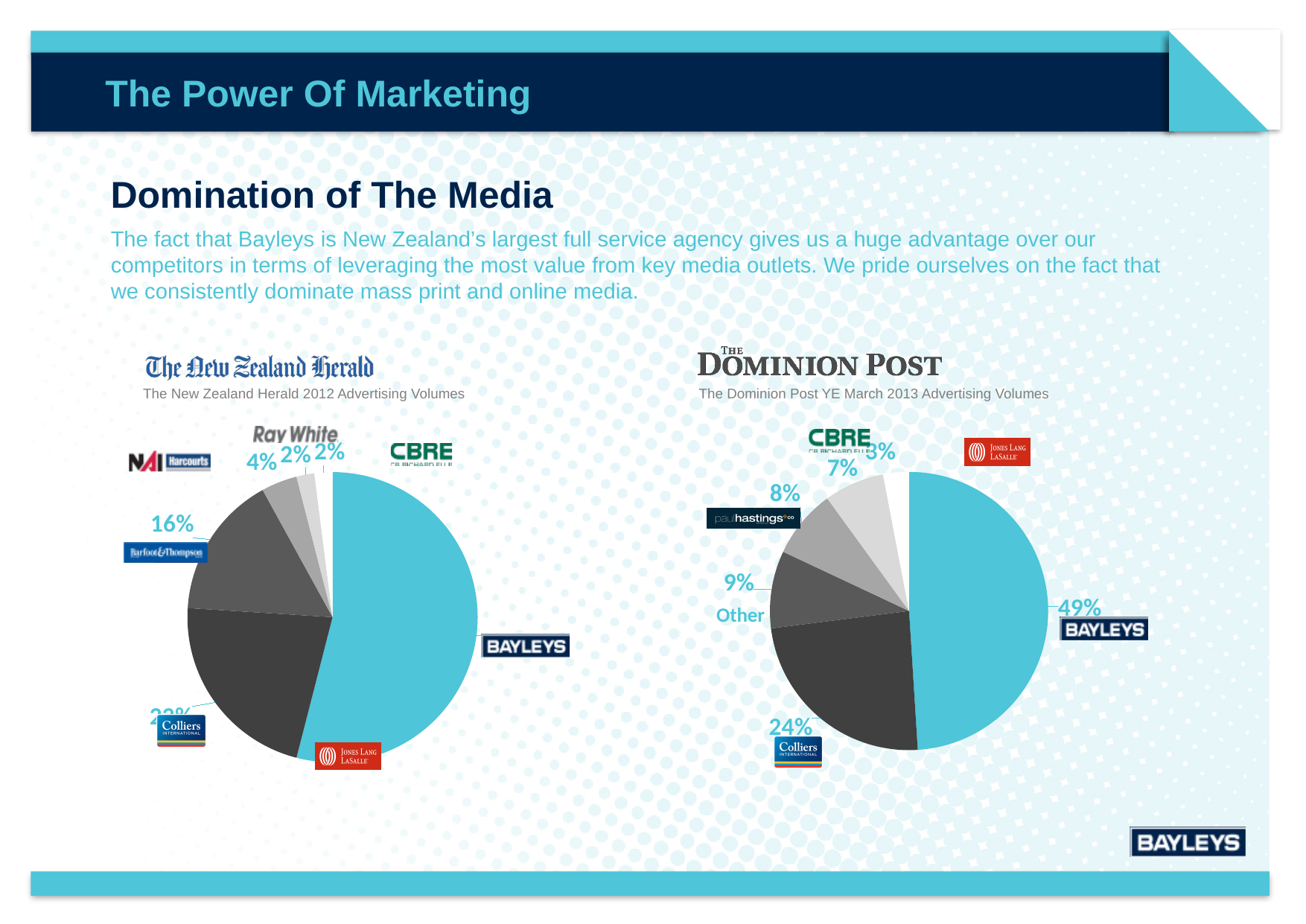
In The Dominion Post YE March 2013 Advertising Volumes chart, which agency has the smallest slice? Jones Lang LaSalle In The Dominion Post YE March 2013 Advertising Volumes chart, how many percentage points larger is Bayleys' share than Colliers' share? 25 percentage points In The Dominion Post YE March 2013 Advertising Volumes chart, what share does Jones Lang LaSalle have? 3% In The New Zealand Herald 2012 Advertising Volumes chart, what share does NAI Harcourts have? 4% In The Dominion Post YE March 2013 Advertising Volumes chart, which agency has the largest slice? Bayleys What kind of chart is used for The Dominion Post YE March 2013 Advertising Volumes? Pie chart In The Dominion Post YE March 2013 Advertising Volumes chart, what share does Colliers have? 24% In The Dominion Post YE March 2013 Advertising Volumes chart, what share does Bayleys have? 49% In The New Zealand Herald 2012 Advertising Volumes chart, what share does Barfoot & Thompson have? 16% In The Dominion Post YE March 2013 Advertising Volumes chart, which is larger: Paul Hastings or CBRE? Paul Hastings In The Dominion Post YE March 2013 Advertising Volumes chart, what share is labelled Other? 9% How many slices does The Dominion Post YE March 2013 Advertising Volumes pie chart have? 6